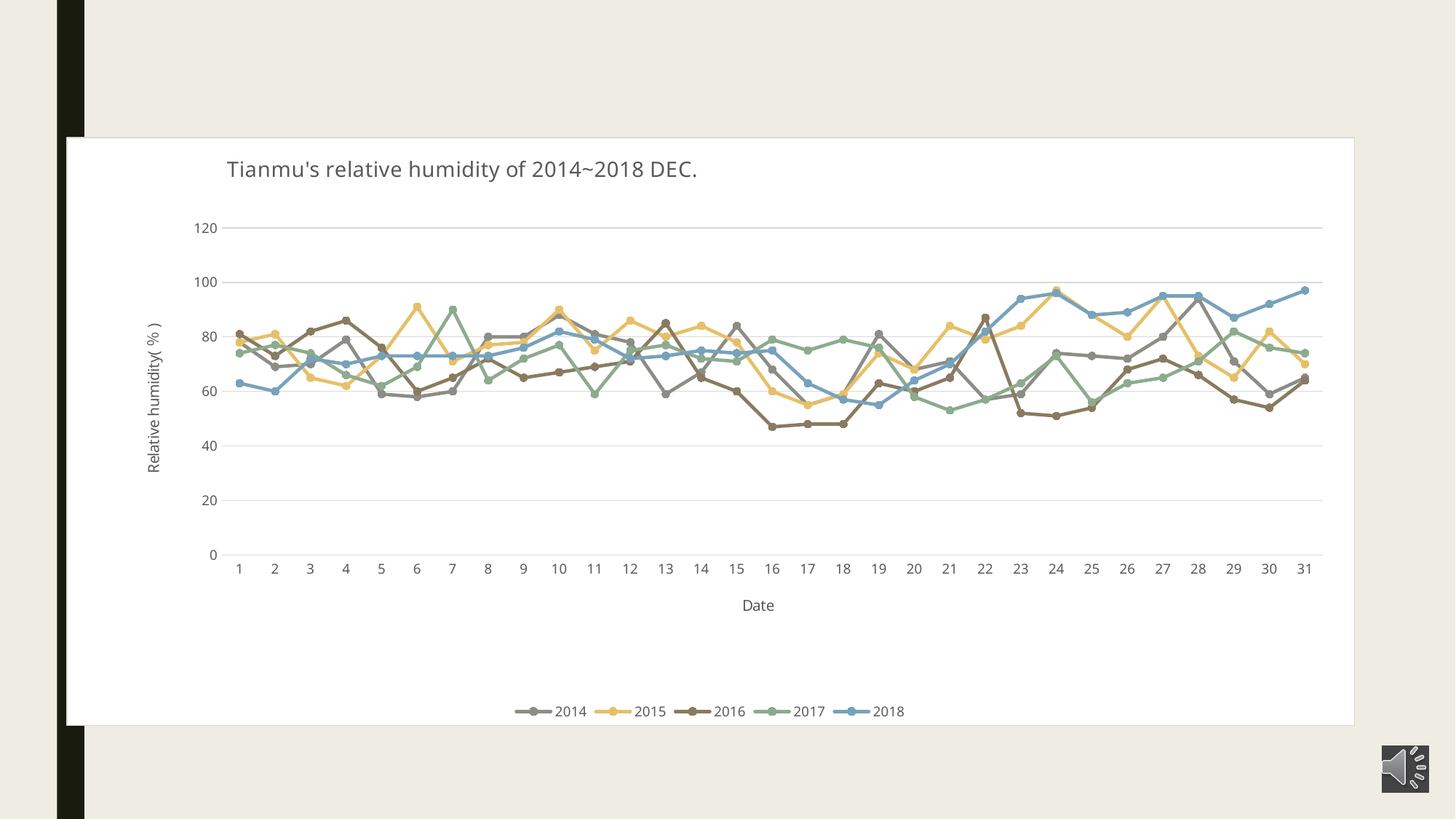
What kind of chart is shown on the slide? line chart How many dates are plotted along the x axis? 31 Is the value for 2016 on date 16 greater or less than 60? less What is the label of the y axis? Relative humidity( % ) Is the value for 2015 on date 6 greater or less than 80? greater Is the value for 2016 on date 24 greater or less than 60? less What is the title of the chart? Tianmu's relative humidity of 2014~2018 DEC. How many series does the legend list? 5 On date 31, which is larger, the value for 2018 or the value for 2016? 2018 Which series has the lowest value on date 16? 2016